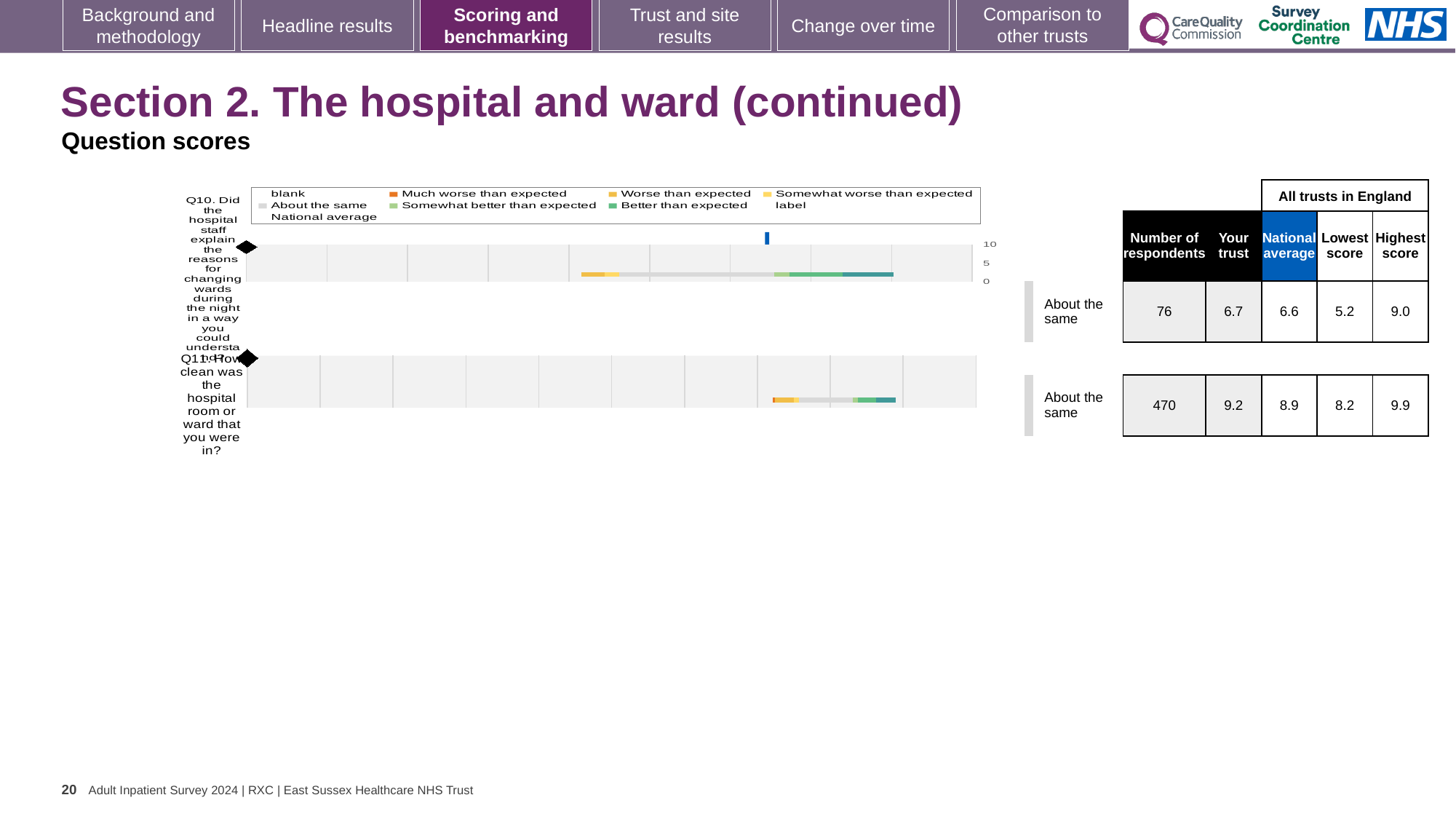
What is the national average score for Q11? 8.9 What is the difference between the highest score (9.0) and the lowest score (5.2) for Q10? 3.8 Which legend entry is shown in dark orange? Much worse than expected What kind of chart is used to show the Q10 and Q11 question scores? bar chart What is the 'Your trust' score for Q10 (explaining reasons for changing wards during the night)? 6.7 What benchmark category is given for Q11? About the same How many questions (Q10 and Q11) have a chart on this slide? 2 What is the highest tick value shown on the axis of the Q10 chart? 10 How many respondents answered Q10? 76 What is the 'Your trust' score for Q11 (how clean was the hospital room or ward)? 9.2 For Q11, which is larger: the 'Your trust' score or the national average? Your trust